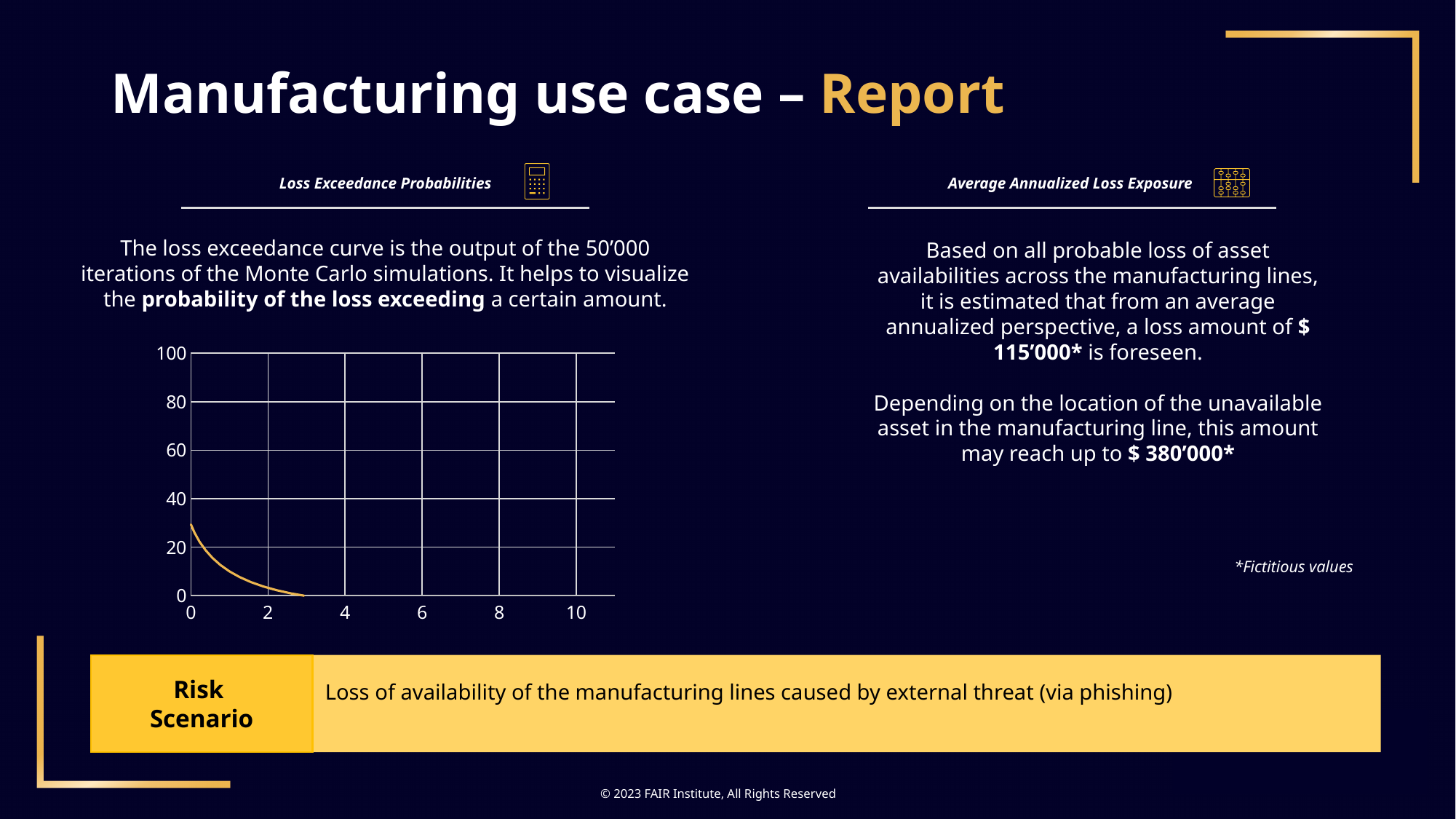
In the Loss Exceedance Probabilities chart, do the values rise or fall as the x axis increases? fall What is the highest value shown on the y axis of the Loss Exceedance Probabilities chart? 100 What is the highest value shown on the x axis of the Loss Exceedance Probabilities chart? 10 How many series are plotted in the Loss Exceedance Probabilities chart? 1 In the Loss Exceedance Probabilities chart, is the value of the curve at x = 2 greater or less than 20? less In the Loss Exceedance Probabilities chart, is the value of the curve at x = 0 greater or less than 40? less In the Loss Exceedance Probabilities chart, is the curve's value at x = 0 larger or smaller than its value at x = 2? larger In the Loss Exceedance Probabilities chart, is the value of the curve at x = 0 greater or less than 20? greater What kind of chart is shown under the heading "Loss Exceedance Probabilities"? line chart